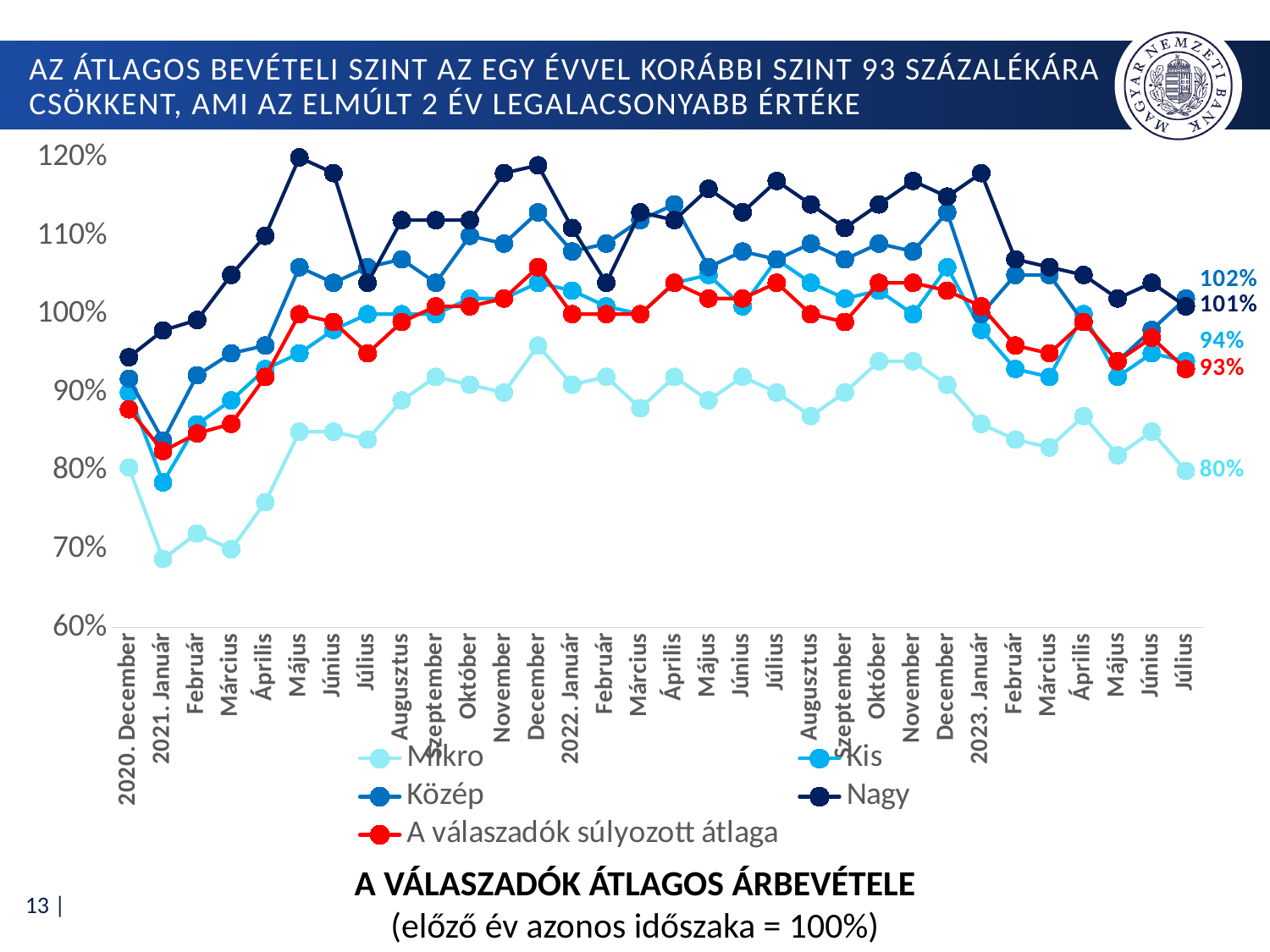
What is the value for Nagy in 2023 Július? 101% What is the value for Kis in 2023 Július? 94% How many series does the legend list? 5 What is the value for A válaszadók súlyozott átlaga in 2023 Július? 93% What type of chart is shown on the slide? line chart Which series has the lowest value in 2023 Július? Mikro Which series has the highest value in 2023 Július? Közép What is the title of the chart? A VÁLASZADÓK ÁTLAGOS ÁRBEVÉTELE What is the value for Mikro in 2023 Július? 80% What is the value for Közép in 2023 Július? 102% Is the value for Nagy in 2021 Május greater or less than 110%? greater What is the difference between the Közép and Mikro values in 2023 Július? 22 percentage points